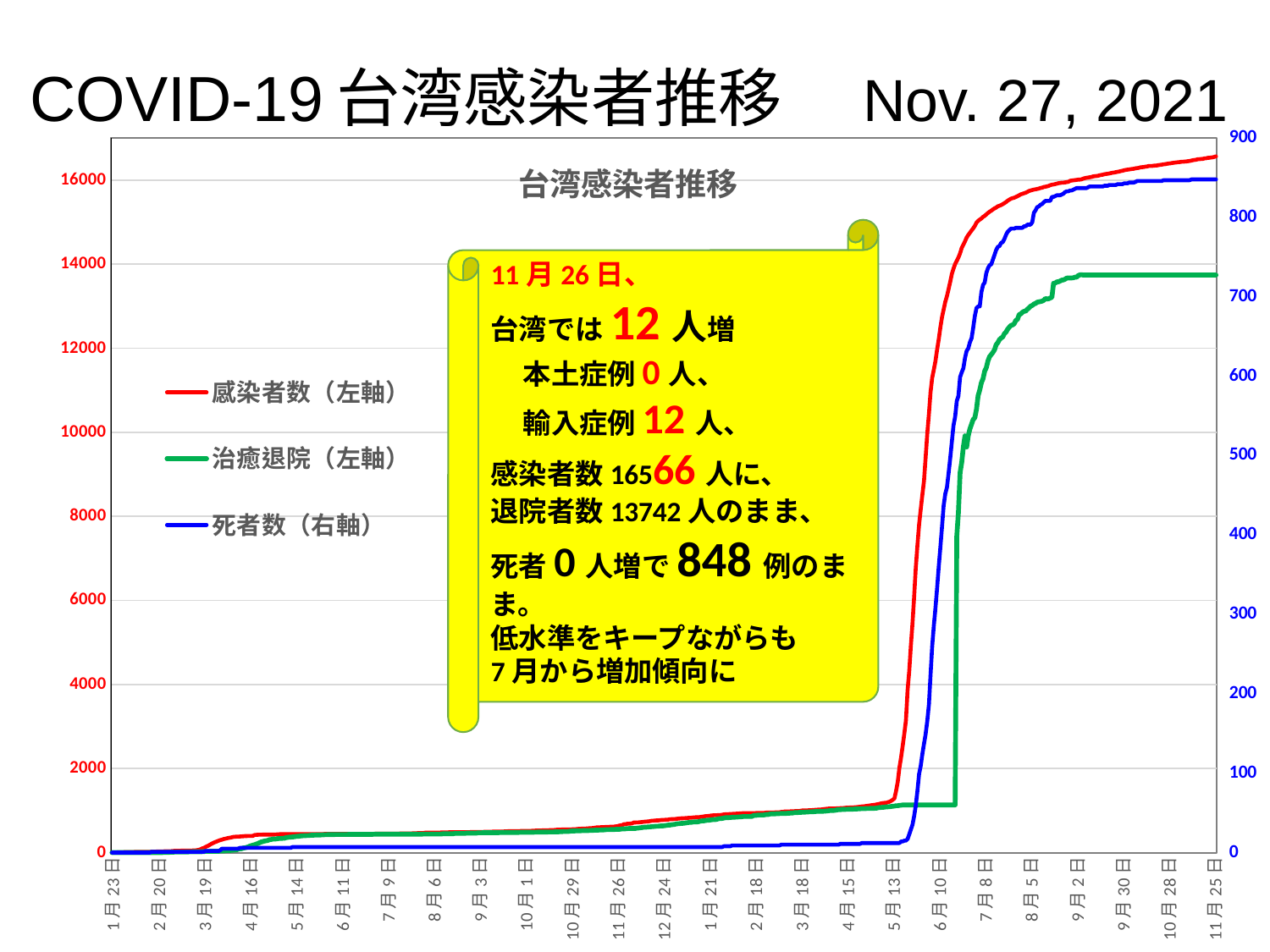
Is the value of 死者数 at 11月25日 greater or less than 800 on the right axis? greater What kind of chart is shown on the slide? line chart How many series does the chart legend list? 3 According to the callout, what is the cumulative number of deaths (死者) as of 11月26日? 848 What is the title of the chart? 台湾感染者推移 Does the 感染者数 (red) line rise or fall from 1月23日 to 11月25日? rise According to the callout, what is the cumulative number of infected (感染者数) as of 11月26日? 16566 Is the value of 感染者数 at 11月25日 greater or less than 16000 on the left axis? greater Is the value of 治癒退院 at 11月25日 greater or less than 14000 on the left axis? less According to the callout, what is the number of discharged patients (退院者数) as of 11月26日? 13742 Which series is plotted against the right axis? 死者数 Using the callout figures, what is the difference between 感染者数 (16566) and 退院者数 (13742)? 2824